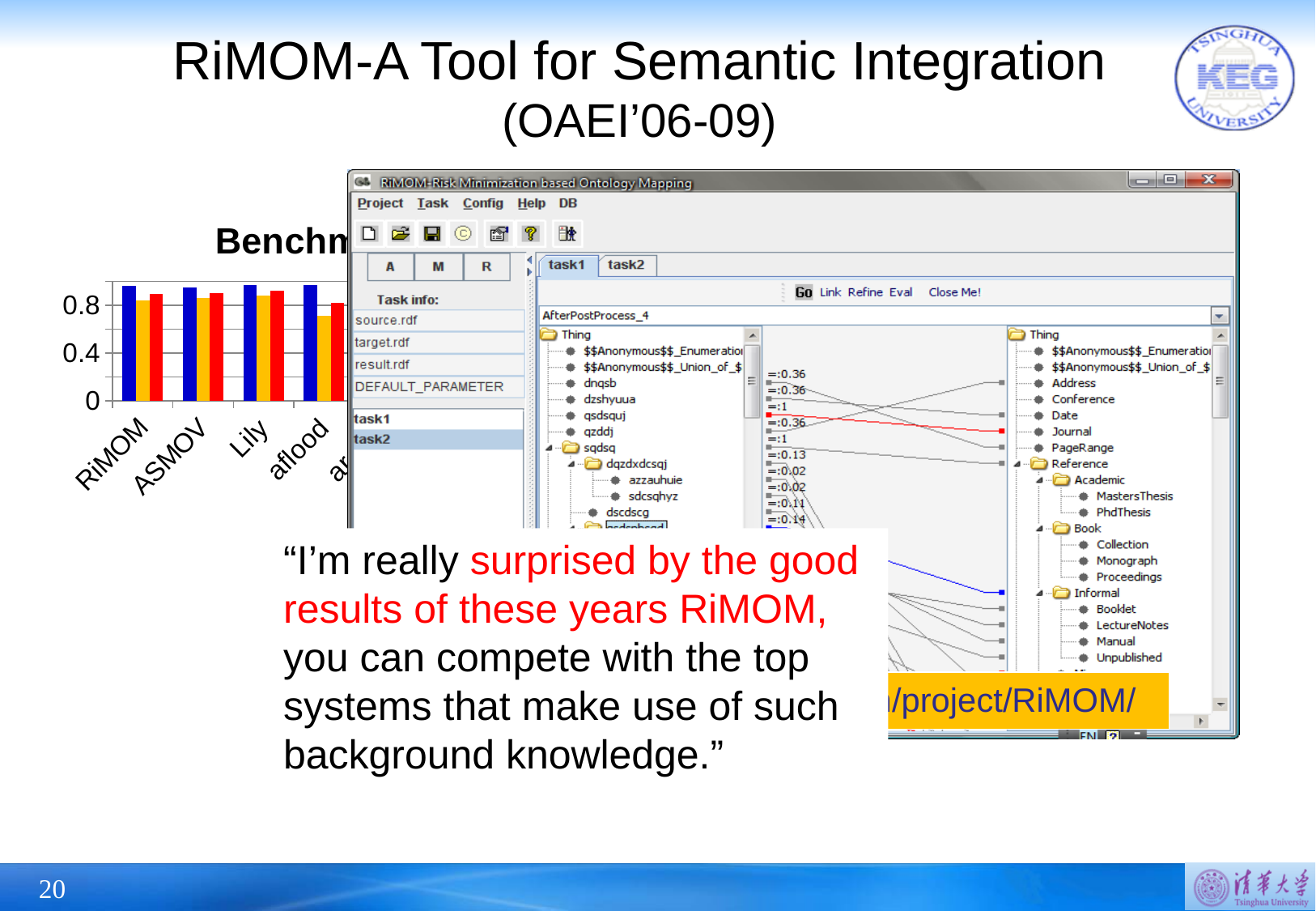
In the bar chart, which is larger for aflood: the blue bar or the yellow bar? the blue bar What is the first category label on the x axis of the bar chart? RiMOM In the bar chart, is the value of the blue bar for ASMOV greater or less than 0.4? greater In the bar chart, which is larger for RiMOM: the blue bar or the yellow bar? the blue bar In the bar chart, is the value of the red bar for Lily greater or less than 0.4? greater What kind of chart is shown on the left of the slide? bar chart In the bar chart, is the value of the blue bar for RiMOM greater or less than 0.8? greater In the bar chart, which is larger for ASMOV: the blue bar or the red bar? the blue bar What is the highest tick value shown on the y axis of the bar chart? 0.8